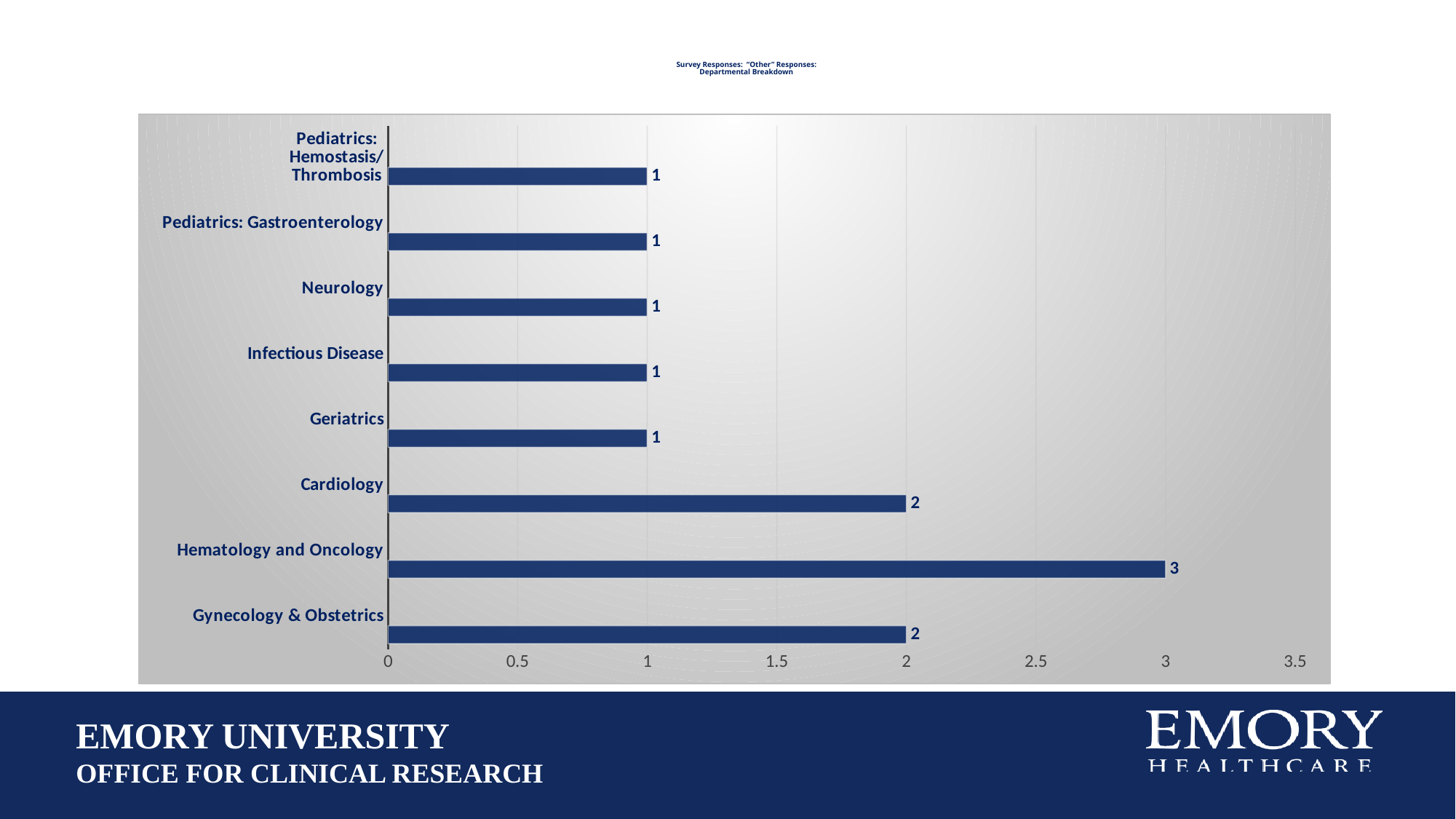
What is the title of the chart? Survey Responses: "Other" Responses: Departmental Breakdown Which department has the highest value? Hematology and Oncology How many departments are shown in the chart? 8 What is the value for Gynecology & Obstetrics? 2 What is the difference between the values for Hematology and Oncology and Cardiology? 1 Which is larger, the value for Cardiology or the value for Geriatrics? Cardiology Is the value for Hematology and Oncology greater or less than 2.5? greater What is the value for Neurology? 1 What kind of chart is shown on the slide? bar chart What is the value for Hematology and Oncology? 3 How many departments have a value of 1? 5 What is the value for Cardiology? 2